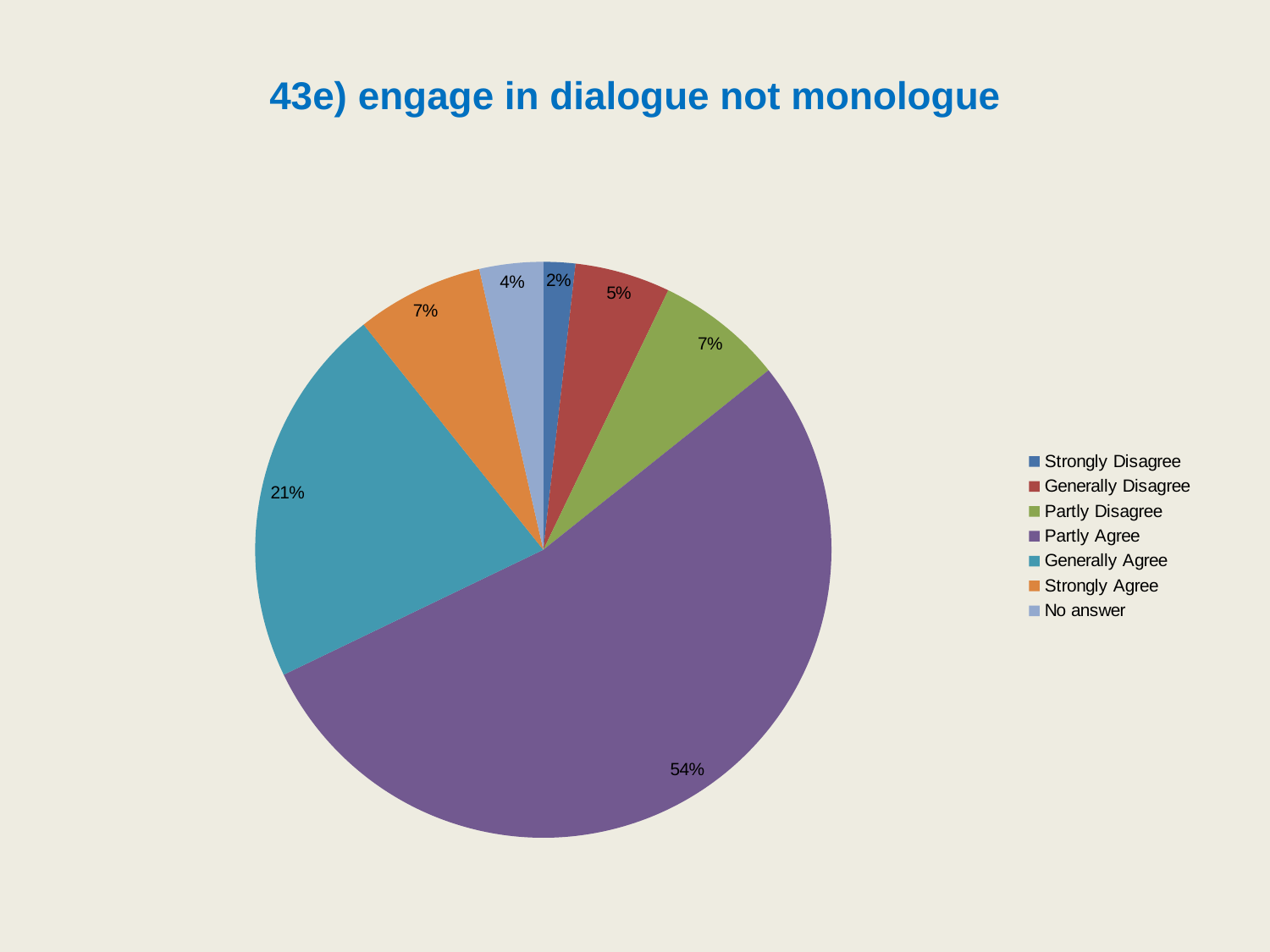
What kind of chart is shown on the slide? pie chart What percentage of the pie is Generally Disagree? 5% How many categories does the legend list? 7 What percentage of the pie is Partly Agree? 54% What percentage of the pie is Generally Agree? 21% What percentage of the pie is No answer? 4% What percentage of the pie is Strongly Disagree? 2% What is the title of the chart? 43e) engage in dialogue not monologue Which category has the largest share of the pie? Partly Agree Which is larger, the share for Generally Disagree or the share for No answer? Generally Disagree Which category has the smallest share of the pie? Strongly Disagree What is the difference in percentage points between Partly Agree and Generally Agree? 33